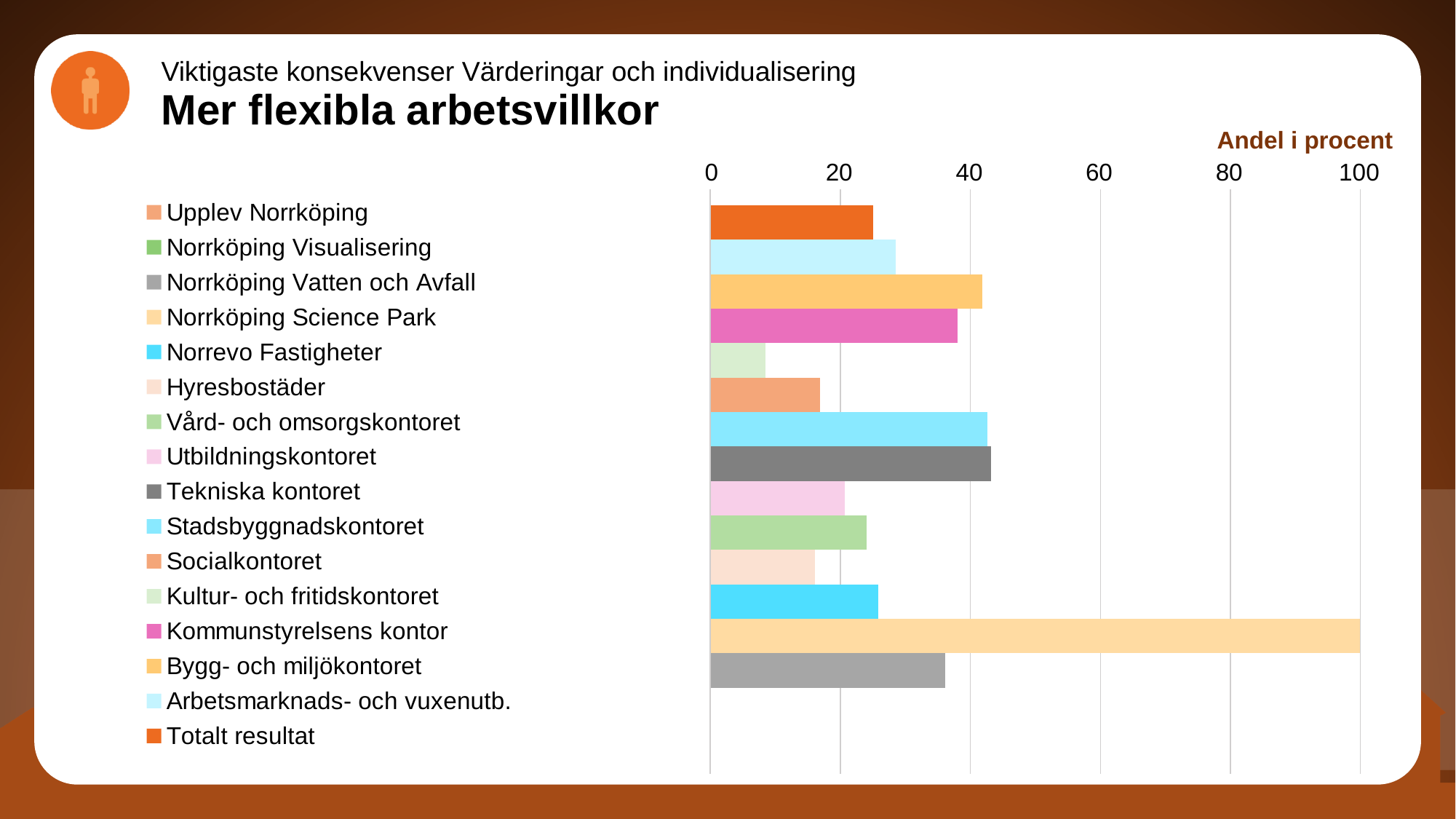
Is the value for Norrköping Vatten och Avfall greater or less than 40? less Which is larger, the value for Norrköping Science Park or the value for Totalt resultat? Norrköping Science Park Is the value for Kultur- och fritidskontoret greater or less than 20? less Which is larger, the value for Socialkontoret or the value for Kultur- och fritidskontoret? Socialkontoret What is the value for Norrköping Science Park? 100 Is the value for Totalt resultat greater or less than 20? greater What label is shown above the chart's horizontal axis? Andel i procent How many entries does the chart legend list? 16 What kind of chart is shown on the slide? bar chart Which category has the highest value in the chart? Norrköping Science Park